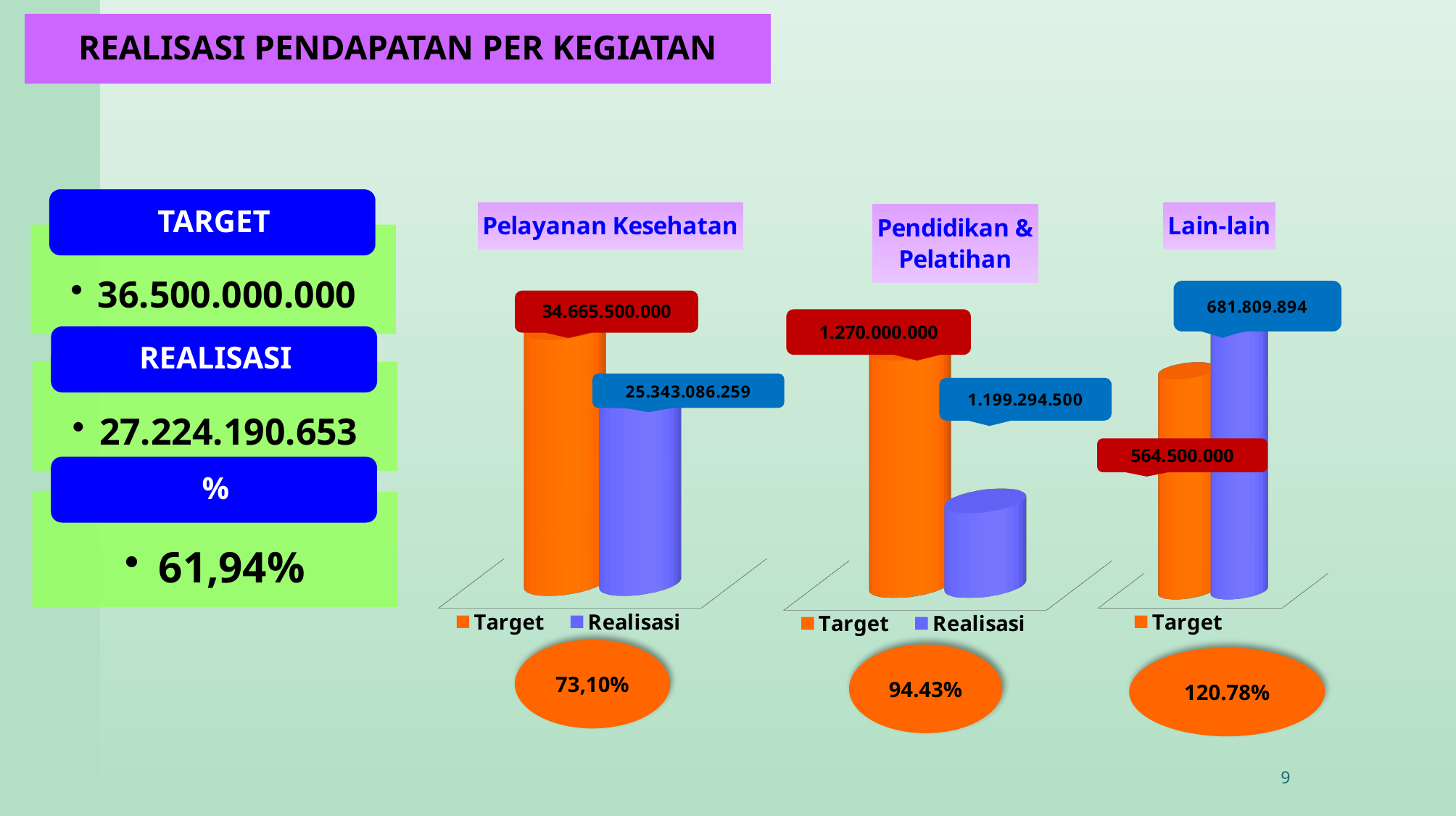
In the Lain-lain chart, which is larger, Target or Realisasi? Realisasi In the Pelayanan Kesehatan chart, what is the difference between the Target and Realisasi values? 9.322.413.741 What kind of chart is the Pelayanan Kesehatan chart? Bar chart In the Pendidikan & Pelatihan chart, what is the value of the Realisasi bar? 1.199.294.500 In the Pelayanan Kesehatan chart, what is the value of the Realisasi bar? 25.343.086.259 In the Lain-lain chart, what is the value of the Realisasi bar? 681.809.894 In the Pendidikan & Pelatihan chart, what is the difference between the Target and Realisasi values? 70.705.500 In the Lain-lain chart, what is the value of the Target bar? 564.500.000 How many series does the legend of the Pelayanan Kesehatan chart list? 2 In the Pelayanan Kesehatan chart, what is the value of the Target bar? 34.665.500.000 In the Pendidikan & Pelatihan chart, what is the value of the Target bar? 1.270.000.000 In the Pendidikan & Pelatihan chart, which is larger, Target or Realisasi? Target